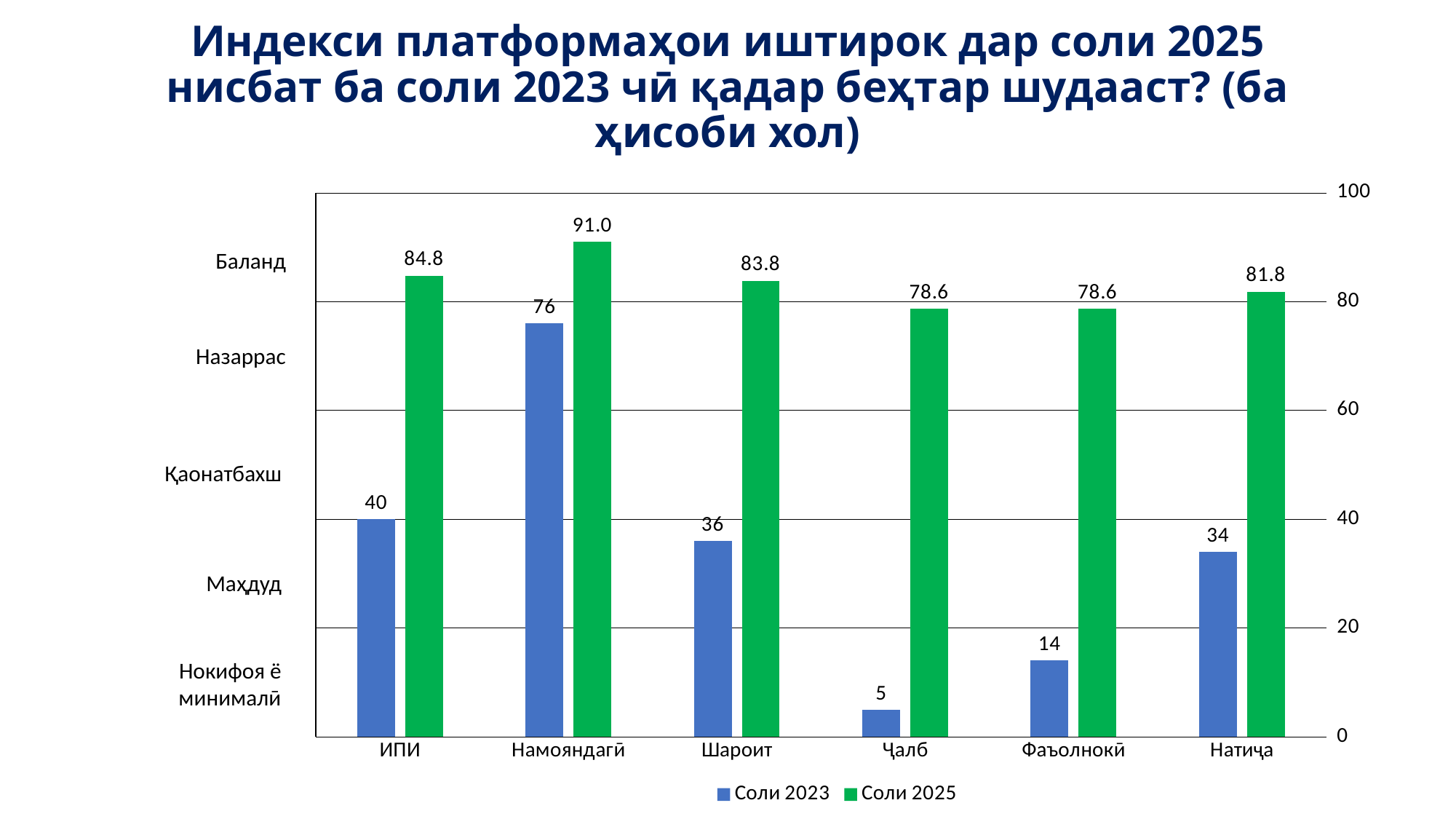
What kind of chart is shown on the slide? Bar chart Which is larger: the Соли 2023 value for Намояндагӣ or the Соли 2023 value for Натиҷа? Намояндагӣ What is the difference between the Соли 2025 and Соли 2023 values for Шароит? 47.8 What is the value for Соли 2023 in the Ҷалб category? 5 What is the value for Соли 2025 in the Намояндагӣ category? 91.0 How many series does the legend list? 2 What is the value for Соли 2023 in the ИПИ category? 40 Which category has the highest value for Соли 2025? Намояндагӣ What is the value for Соли 2023 in the Фаъолнокӣ category? 14 How many categories are shown on the x axis? 6 Which category has the lowest value for Соли 2023? Ҷалб Which colour represents the Соли 2025 series? Green